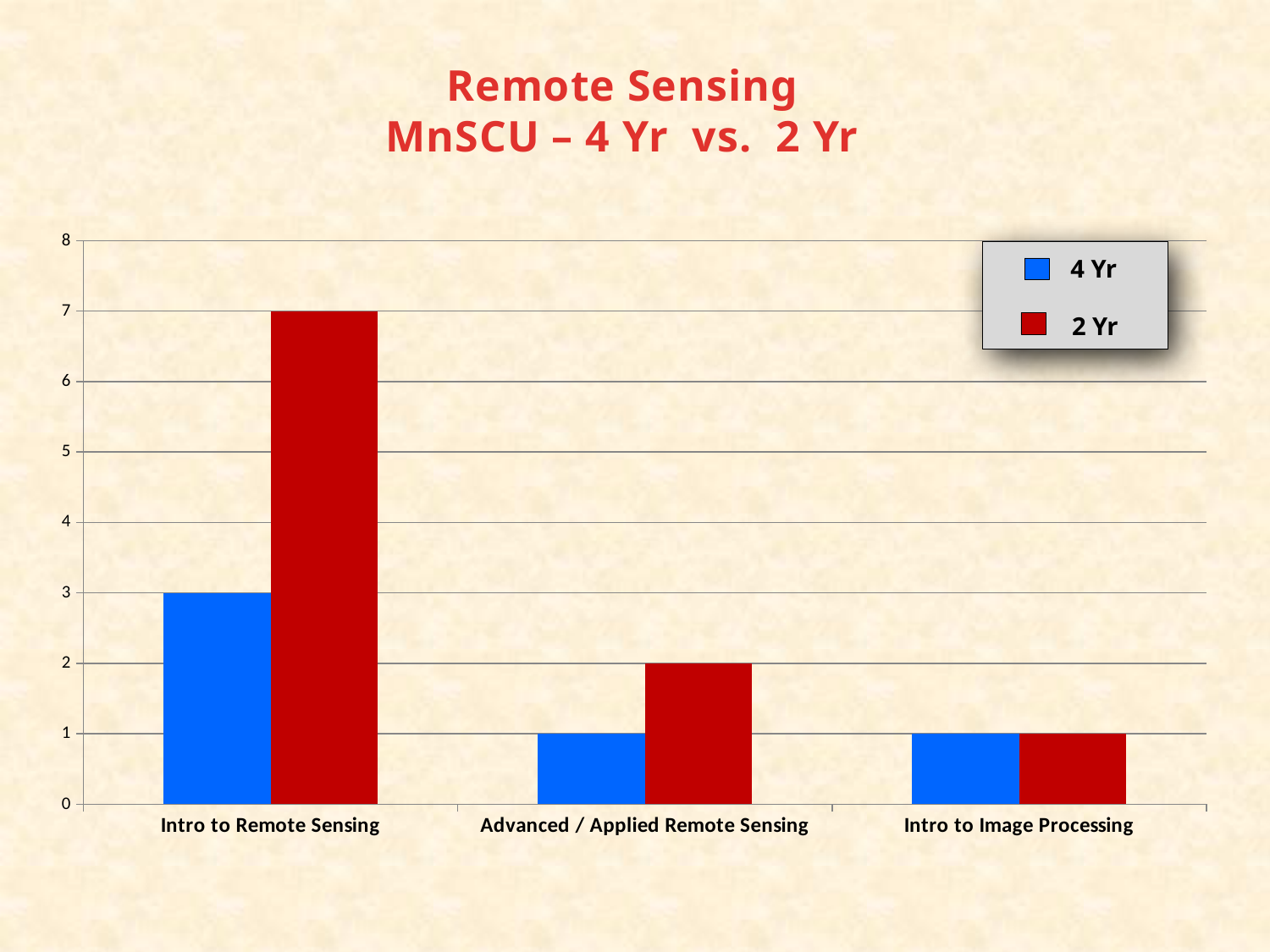
Which category has the highest 2 Yr value? Intro to Remote Sensing What is the difference between the 2 Yr and 4 Yr values for Intro to Remote Sensing? 4 How many series does the legend list? 2 What is the 4 Yr value for Intro to Remote Sensing? 3 What colour represents the 2 Yr series in the legend? red Which category has the lowest 2 Yr value? Intro to Image Processing What is the 2 Yr value for Advanced / Applied Remote Sensing? 2 What is the 4 Yr value for Intro to Image Processing? 1 What is the 2 Yr value for Intro to Remote Sensing? 7 How many course categories are shown on the x axis? 3 What kind of chart is shown on the slide? bar chart For Advanced / Applied Remote Sensing, which is larger, the 4 Yr value or the 2 Yr value? 2 Yr